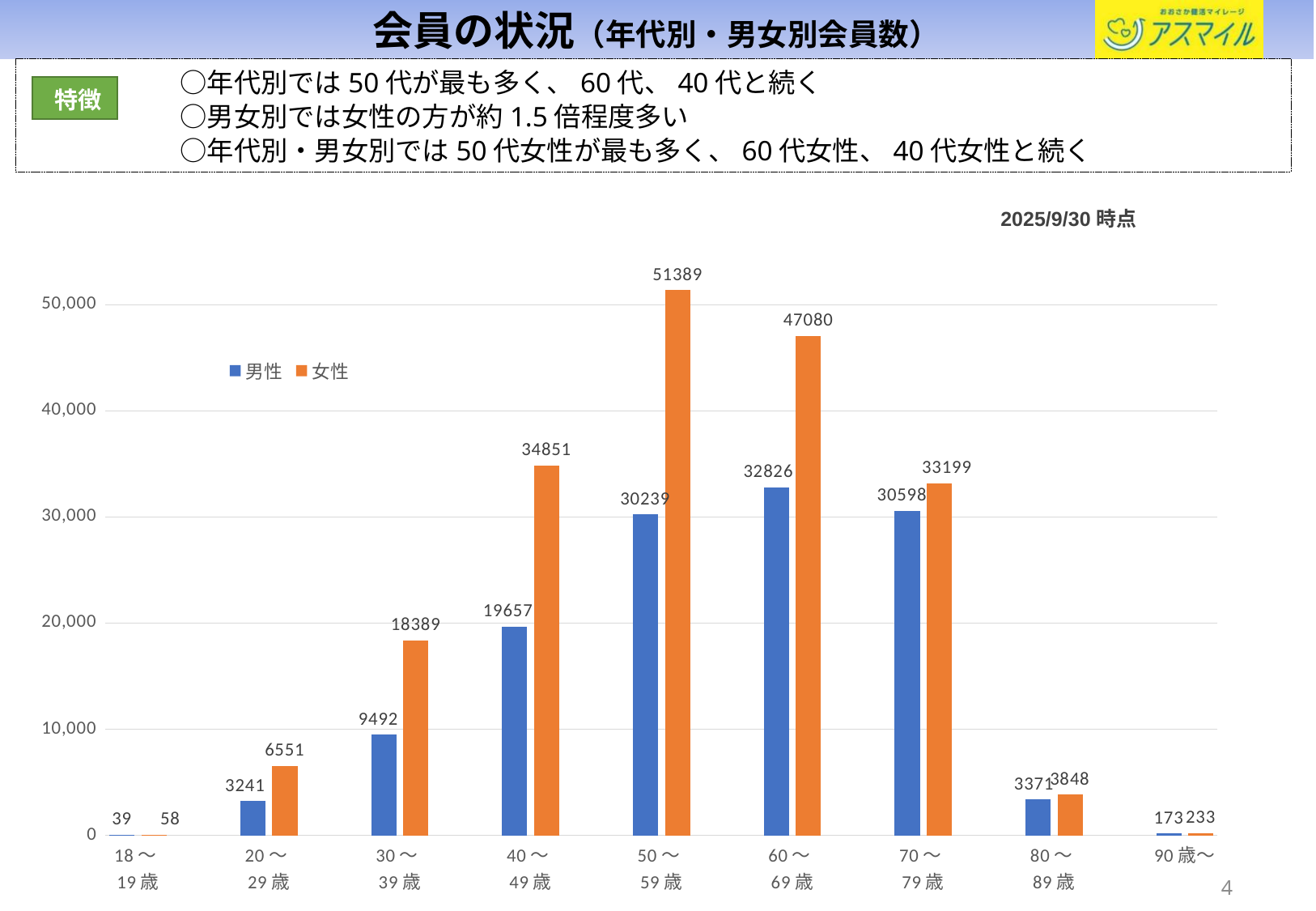
What is the value for 男性 in the 40〜49歳 age group? 19657 What is the value for 女性 in the 50〜59歳 age group? 51389 What kind of chart is shown on the slide? bar chart Which age group has the lowest value for 男性? 18〜19歳 Is the value for 女性 in the 40〜49歳 age group greater or less than 30,000? greater What date is the chart data stated to be as of? 2025/9/30 What is the value for 男性 in the 80〜89歳 age group? 3371 How many age groups are shown on the x axis? 9 Which is larger, the 男性 value for 60〜69歳 or the 男性 value for 70〜79歳? 60〜69歳 Which age group has the highest value for 女性? 50〜59歳 What is the difference between the 女性 and 男性 values in the 60〜69歳 age group? 14254 How many series does the legend list? 2